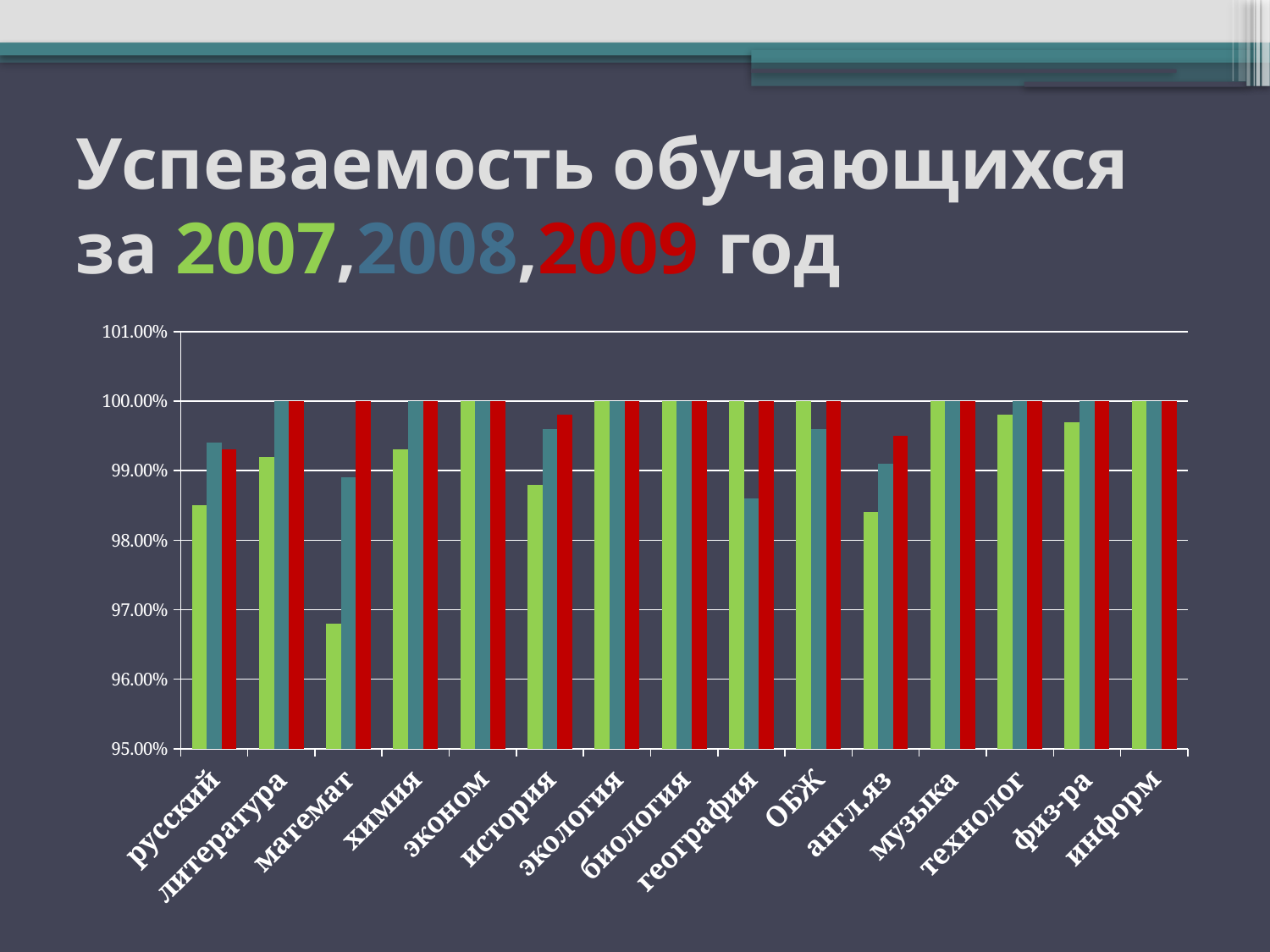
Is the value for англ.яз in 2007 greater or less than 99.00%? less Which subject has the lowest value for 2007? математ Is the value for русский in 2007 greater or less than 99.00%? less Which colour represents 2009 in the chart? red Which years are compared in the chart, according to the slide title? 2007, 2008, 2009 What is the value for математ in 2009? 100.00% For математ, which year has the larger value, 2007 or 2009? 2009 For русский, which year has the larger value, 2007 or 2008? 2008 Is the value for математ in 2007 greater or less than 97.00%? less What is the value for экология in 2007? 100.00% How many subject categories are shown on the x axis of the chart? 15 What kind of chart is shown on the slide? bar chart